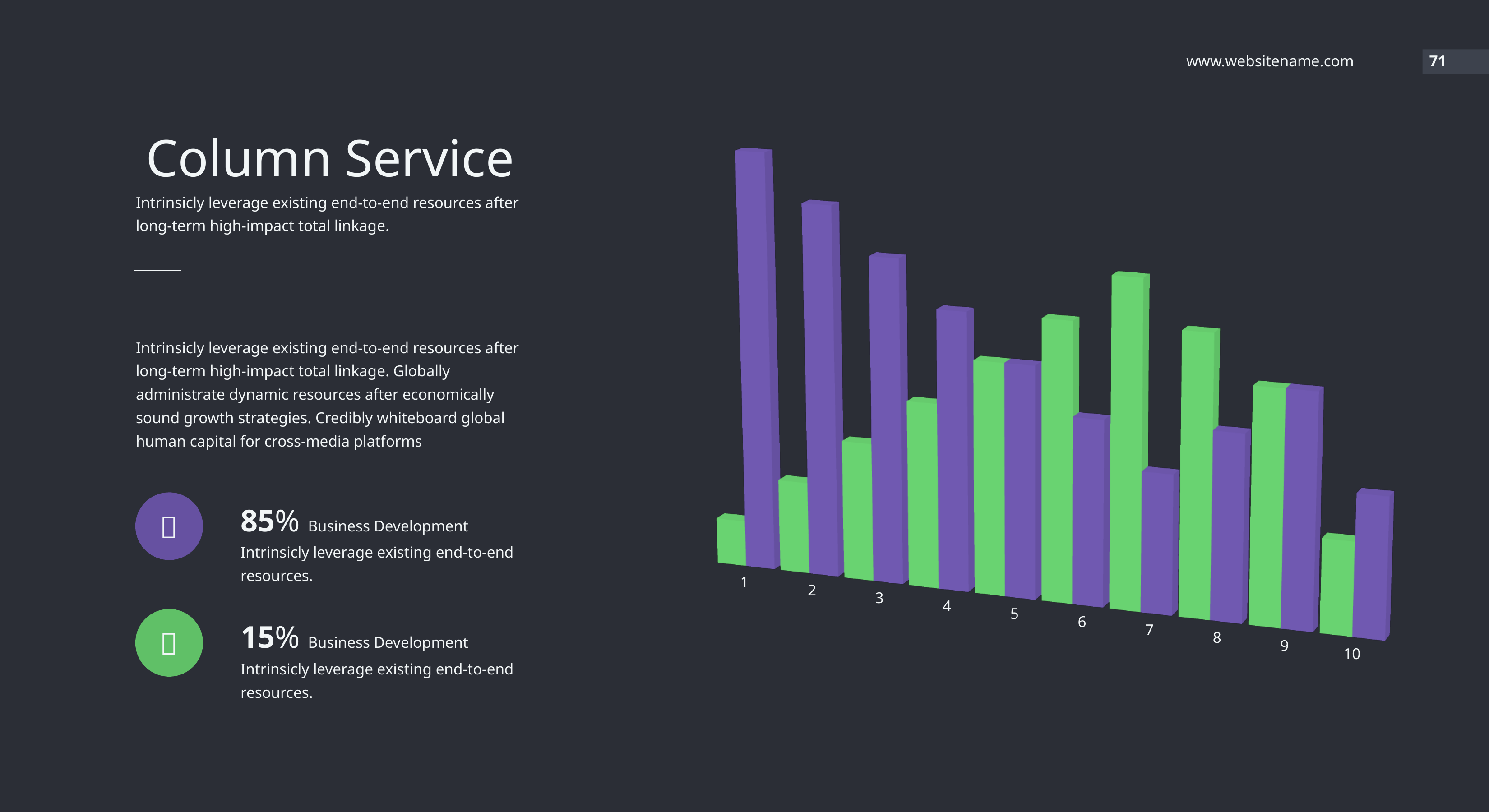
How many categories are shown on the x axis of the chart? 10 At category 7, which bar is taller, the green one or the purple one? green What kind of chart is shown on the slide? bar chart At category 10, which bar is taller, the green one or the purple one? purple What is the title of the slide containing the chart? Column Service Which category has the tallest purple bar? 1 At category 1, which bar is taller, the green one or the purple one? purple Which category has the tallest green bar? 7 How many data series (bar colours) are plotted in the chart? 2 Do the purple bars rise or fall from category 1 to category 5? fall Which category has the shortest green bar? 1 Do the green bars rise or fall from category 1 to category 7? rise